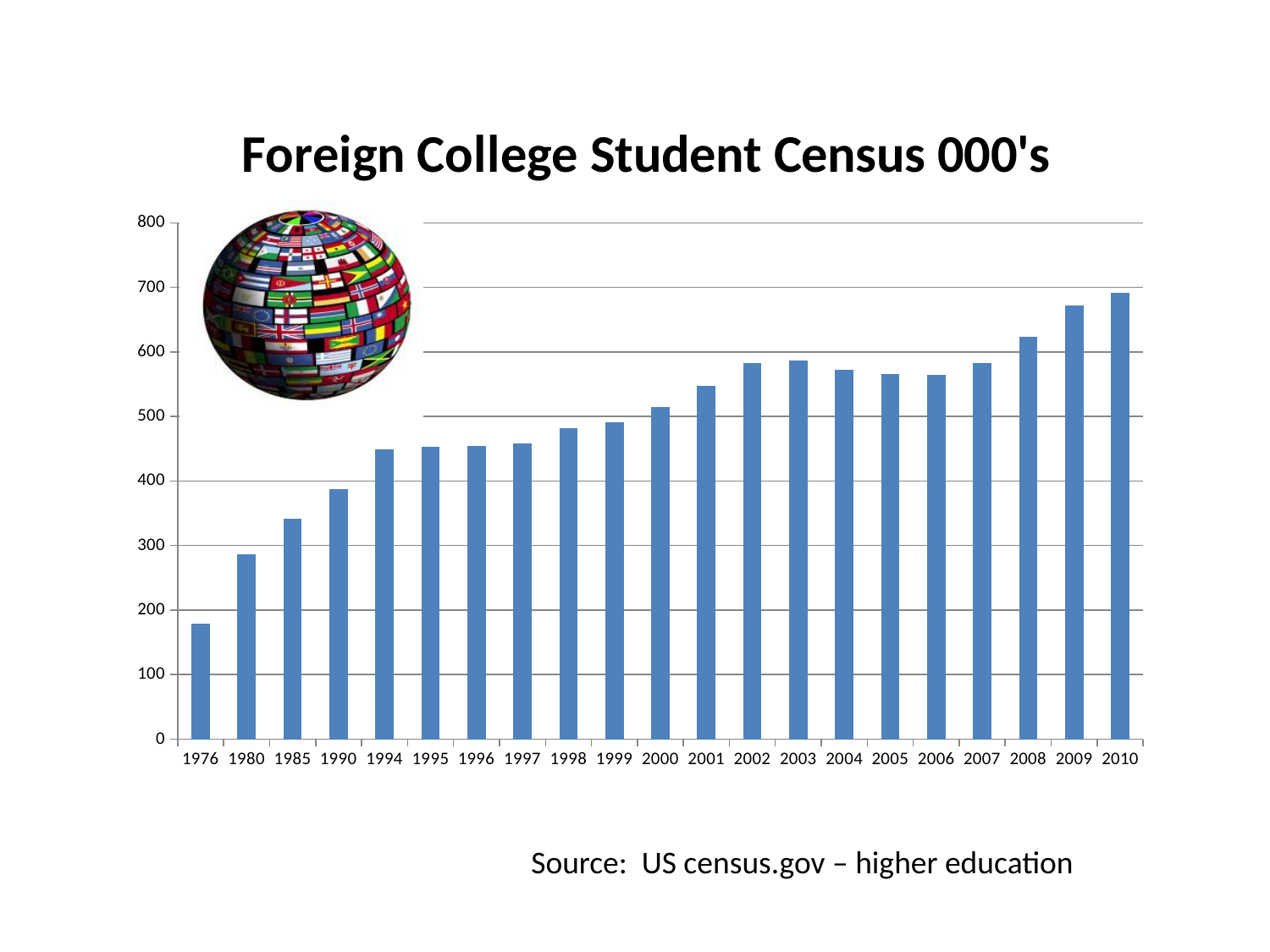
Which year has the lowest value in the chart? 1976 Which year has the highest value in the chart? 2010 Is the value for 1976 greater or less than 200? less Is the value for 2008 greater or less than 600? greater Do the values generally rise or fall from 1976 to 2010? Rise What type of chart is shown on the slide? Bar chart Is the value for 2000 greater or less than 500? greater Which year has the larger value, 1985 or 1990? 1990 Which year has the larger value, 2008 or 2009? 2009 How many years are shown on the x axis of the chart? 21 What is the title of the chart? Foreign College Student Census 000's